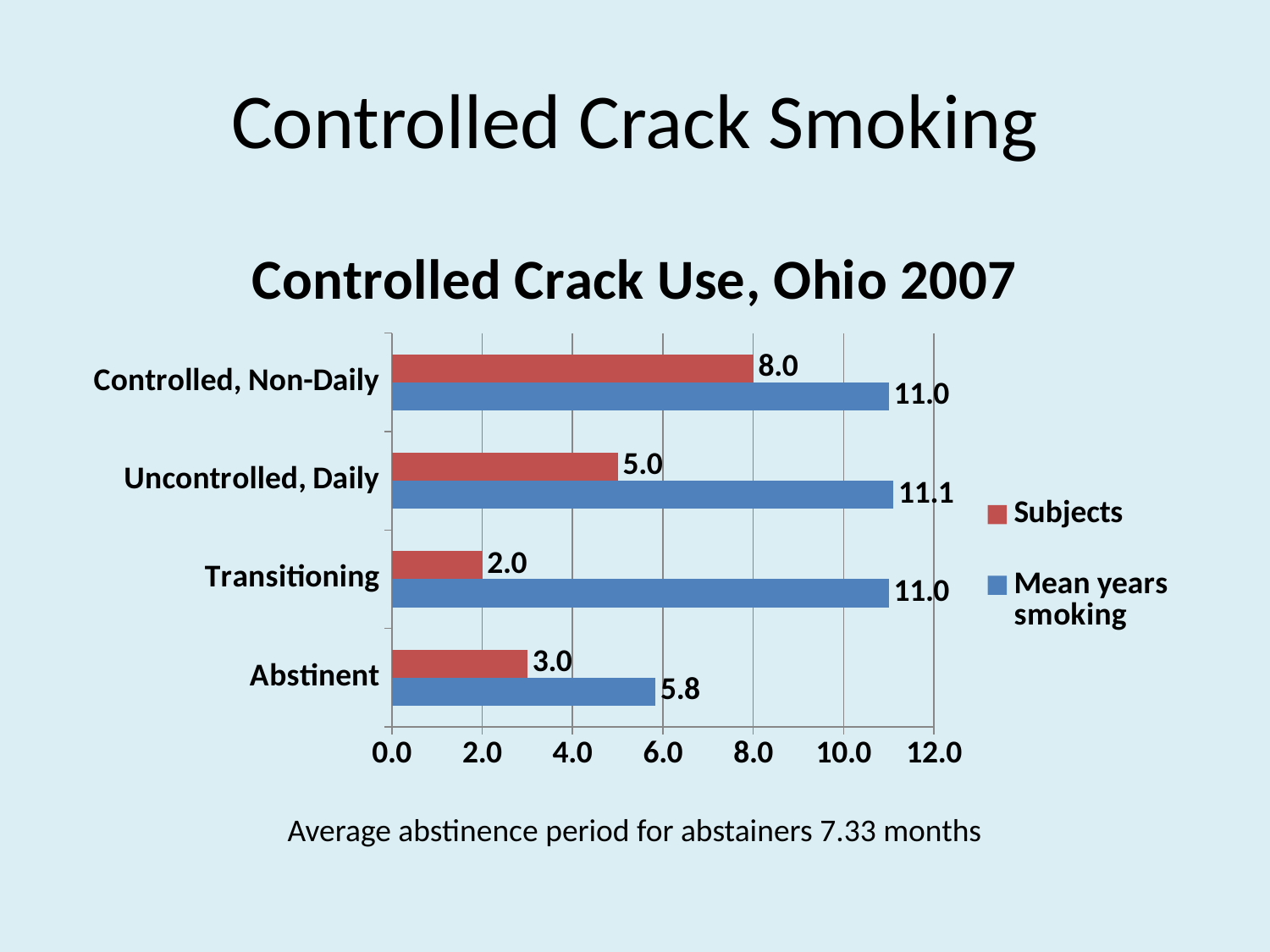
Which category has the lowest number of Subjects? Transitioning What type of chart is shown on the slide? Bar chart What is the number of Subjects for the Controlled, Non-Daily category? 8.0 How many categories are shown on the chart? 4 What is the Mean years smoking value for the Uncontrolled, Daily category? 11.1 Which is larger: the number of Subjects for Abstinent or for Transitioning? Abstinent What is the difference in Subjects between Controlled, Non-Daily and Uncontrolled, Daily? 3.0 Which category has the lowest Mean years smoking? Abstinent What is the Mean years smoking value for the Abstinent category? 5.8 Which category has the highest number of Subjects? Controlled, Non-Daily What is the difference in Mean years smoking between Transitioning and Abstinent? 5.2 How many series does the legend list? 2